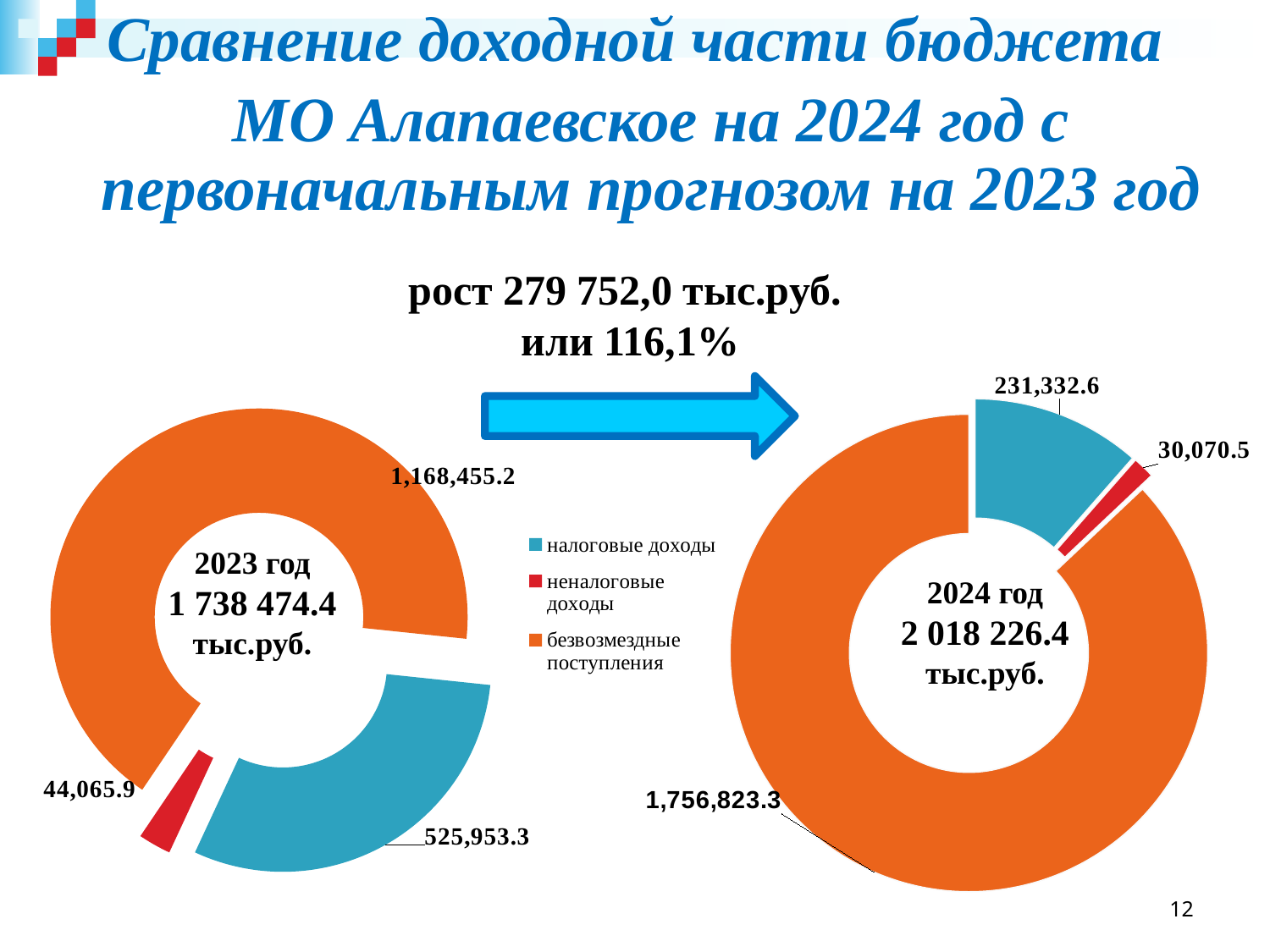
In the 2024 год chart, what is the value for налоговые доходы? 231,332.6 Which is larger: налоговые доходы in the 2023 год chart or налоговые доходы in the 2024 год chart? 2023 год (525,953.3) What type of chart is used on this slide? Doughnut (pie) chart In the 2023 год chart, what is the difference between налоговые доходы and неналоговые доходы? 481,887.4 How many series does the legend list? 3 In the 2024 год chart, what is the value for безвозмездные поступления? 1,756,823.3 In the 2023 год chart, which category has the largest value? безвозмездные поступления In the 2023 год chart, what is the value for налоговые доходы? 525,953.3 What is the total shown in the centre of the 2024 год chart? 2 018 226.4 тыс.руб. In the 2024 год chart, which category has the smallest value? неналоговые доходы In the 2023 год chart, what is the value for неналоговые доходы? 44,065.9 Which colour represents безвозмездные поступления in the legend? Orange